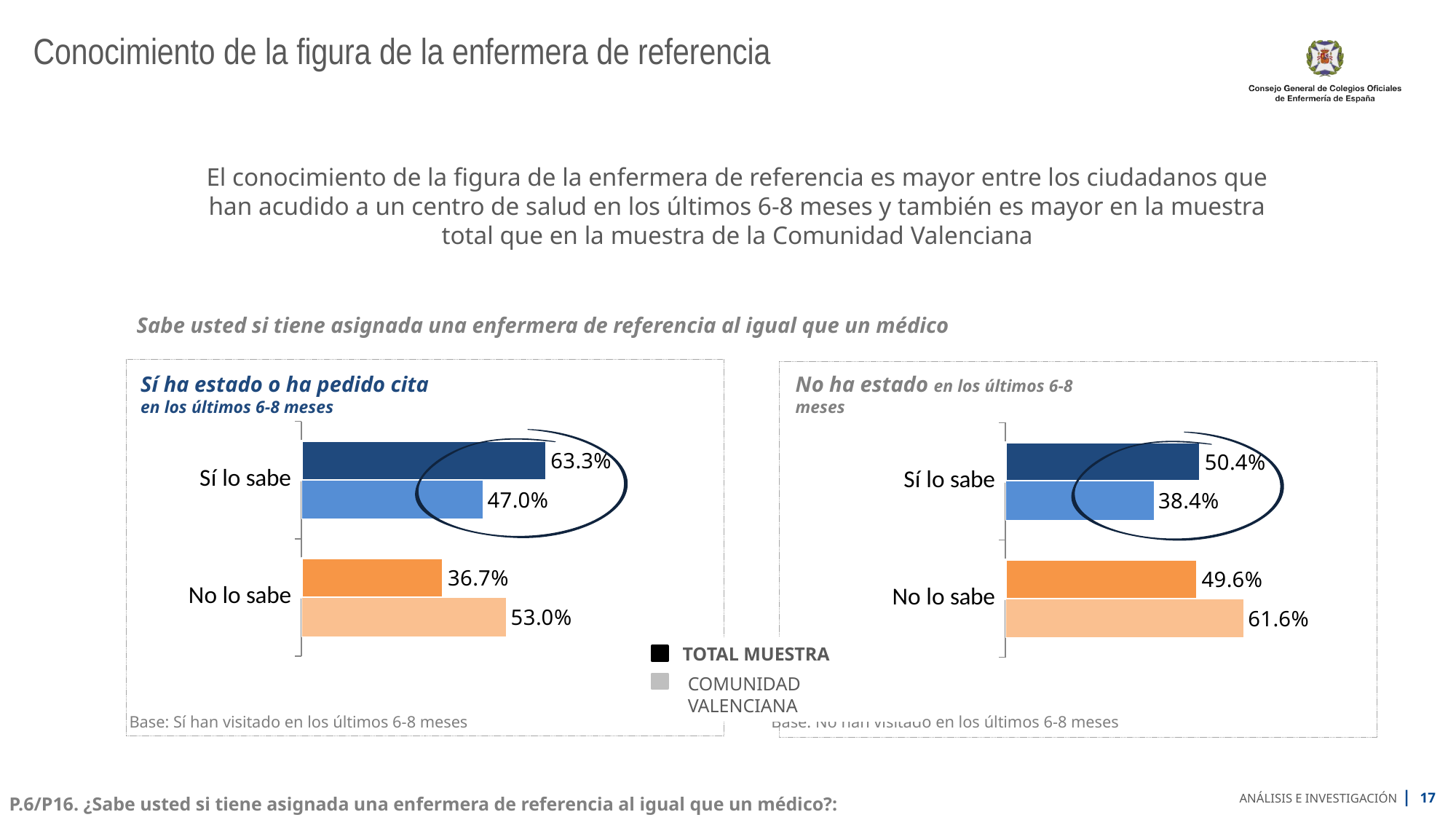
In the left chart (Sí ha estado o ha pedido cita), what is the value of the lower bar for 'No lo sabe'? 53.0% In the right chart (No ha estado), what is the difference between the two 'No lo sabe' bars (61.6% and 49.6%)? 12.0 percentage points In the left chart (Sí ha estado o ha pedido cita), which bar has the highest value? Sí lo sabe, 63.3% In the left chart (Sí ha estado o ha pedido cita), what is the difference between the two 'Sí lo sabe' bars (63.3% and 47.0%)? 16.3 percentage points In the left chart (Sí ha estado o ha pedido cita), what is the value of the upper bar for 'Sí lo sabe'? 63.3% In the left chart (Sí ha estado o ha pedido cita), which bar has the lowest value? No lo sabe, 36.7% How many series does the legend list? 2 In the right chart (No ha estado), which is larger for the upper bars: 'Sí lo sabe' (50.4%) or 'No lo sabe' (49.6%)? Sí lo sabe What are the two series named in the legend? Total muestra and Comunidad Valenciana In the right chart (No ha estado en los últimos 6-8 meses), what is the value of the upper bar for 'Sí lo sabe'? 50.4% In the right chart (No ha estado en los últimos 6-8 meses), what is the value of the lower bar for 'No lo sabe'? 61.6% What type of chart is used on this slide? Bar chart